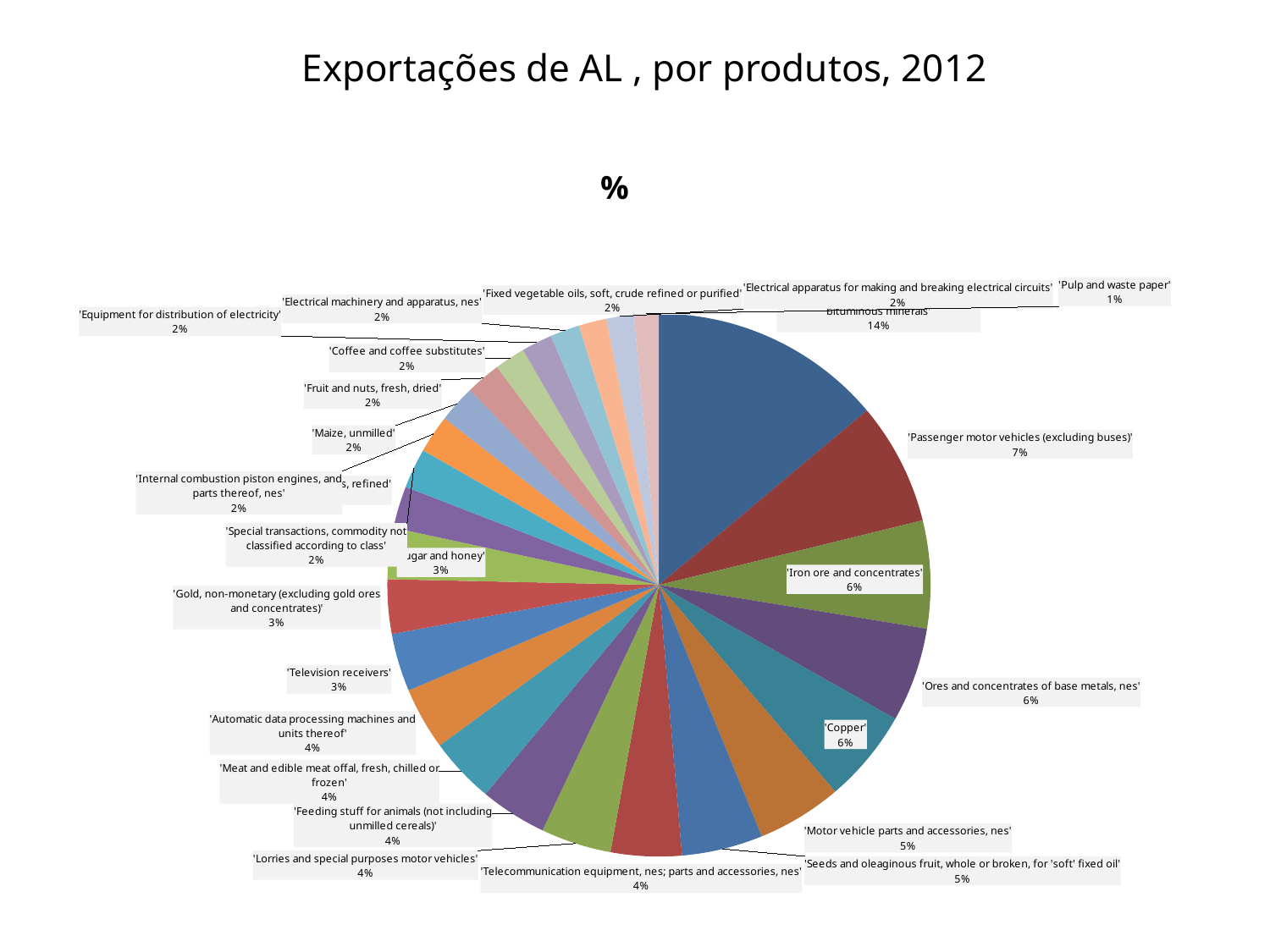
What type of chart is shown on the slide? pie chart What share of exports does 'Iron ore and concentrates' represent? 6% Which product has the smallest share in the pie chart? 'Pulp and waste paper' What is the largest percentage shown on the pie chart? 14% What share of exports does 'Copper' represent? 6% What share of exports does 'Motor vehicle parts and accessories, nes' represent? 5% What is the title of the chart on the slide? % What is the difference between the share for 'Passenger motor vehicles (excluding buses)' and the share for 'Pulp and waste paper'? 6% Which is larger: the share for 'Passenger motor vehicles (excluding buses)' or the share for 'Maize, unmilled'? 'Passenger motor vehicles (excluding buses)'